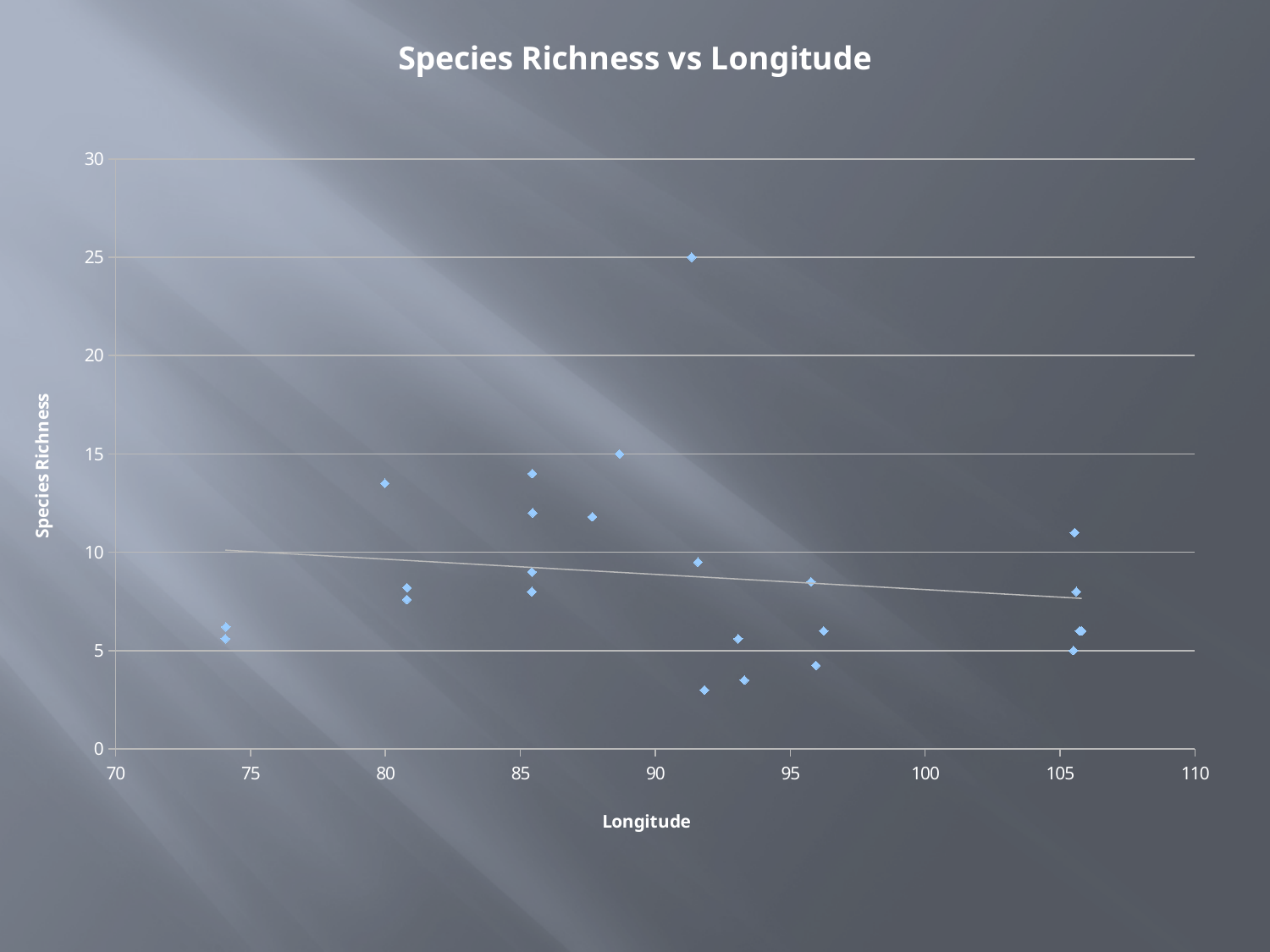
Is the highest species richness point located at a longitude greater or less than 90? greater Which has the higher species richness: the point near longitude 80 or the points near longitude 74? the point near longitude 80 What are the x-axis and y-axis titles of the chart? Longitude and Species Richness What kind of chart is shown on the slide? scatter chart Is the species richness of the highest point in the chart greater or less than 20? greater Is the species richness of the lowest point in the chart greater or less than 5? less What is the title of the chart? Species Richness vs Longitude Does the trendline in the chart rise or fall as longitude increases? fall